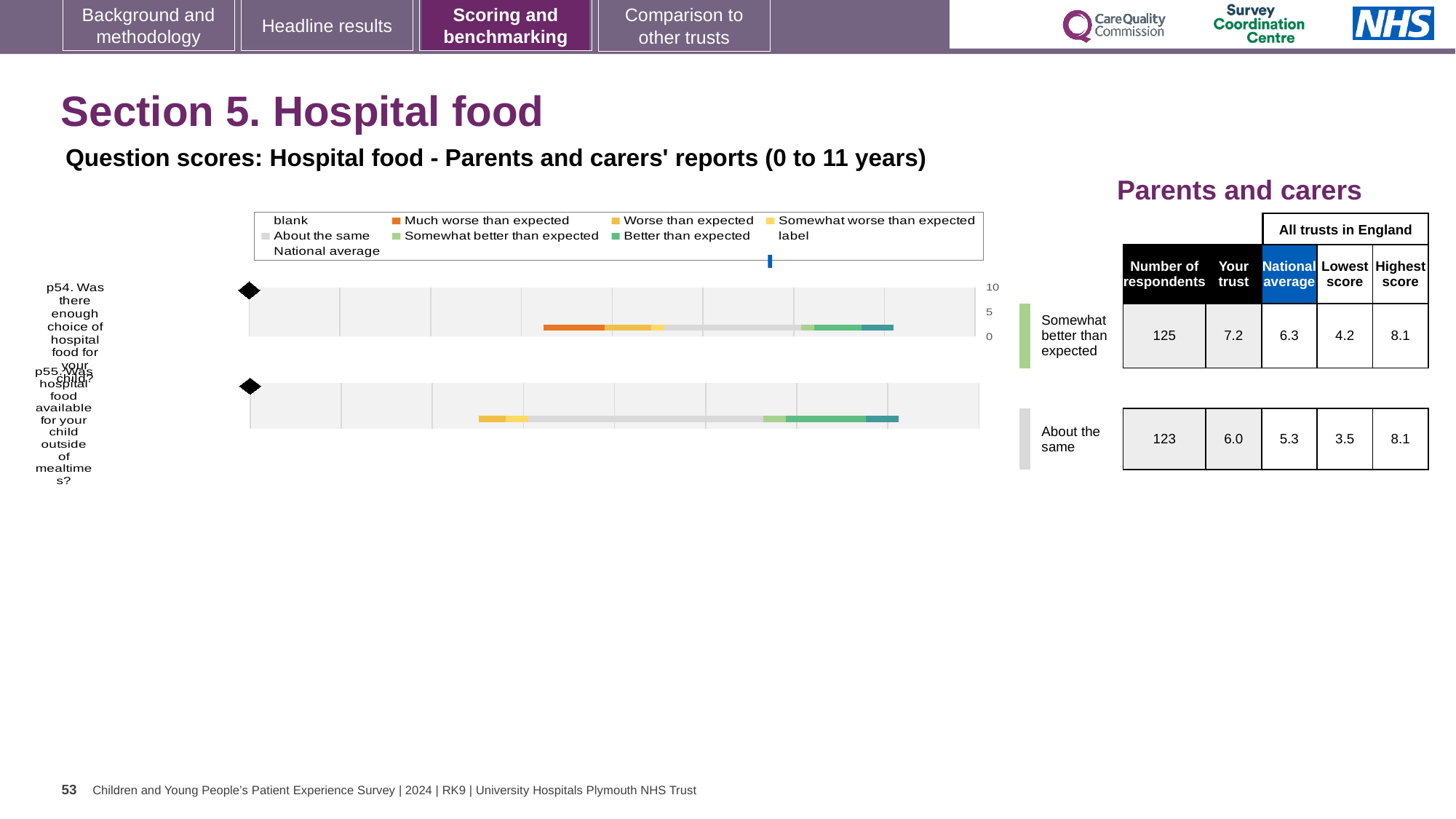
What benchmark category is given for p55? About the same Which question has the higher 'Your trust' score, p54 or p55? p54 What is the difference between the trust's score and the national average for p55? 0.7 Which legend entry is shown in orange? Much worse than expected How many respondents answered p54? 125 What kind of chart is shown on the slide? Bar chart What is the highest value shown on the chart's axis? 10 How many questions (categories) are plotted in the chart? 2 What is the 'Your trust' score for p54 (enough choice of hospital food for your child)? 7.2 What is the national average score for p55 (hospital food available outside of mealtimes)? 5.3 What is the difference between the trust's score and the national average for p54? 0.9 What is the lowest score among all trusts in England for p55? 3.5